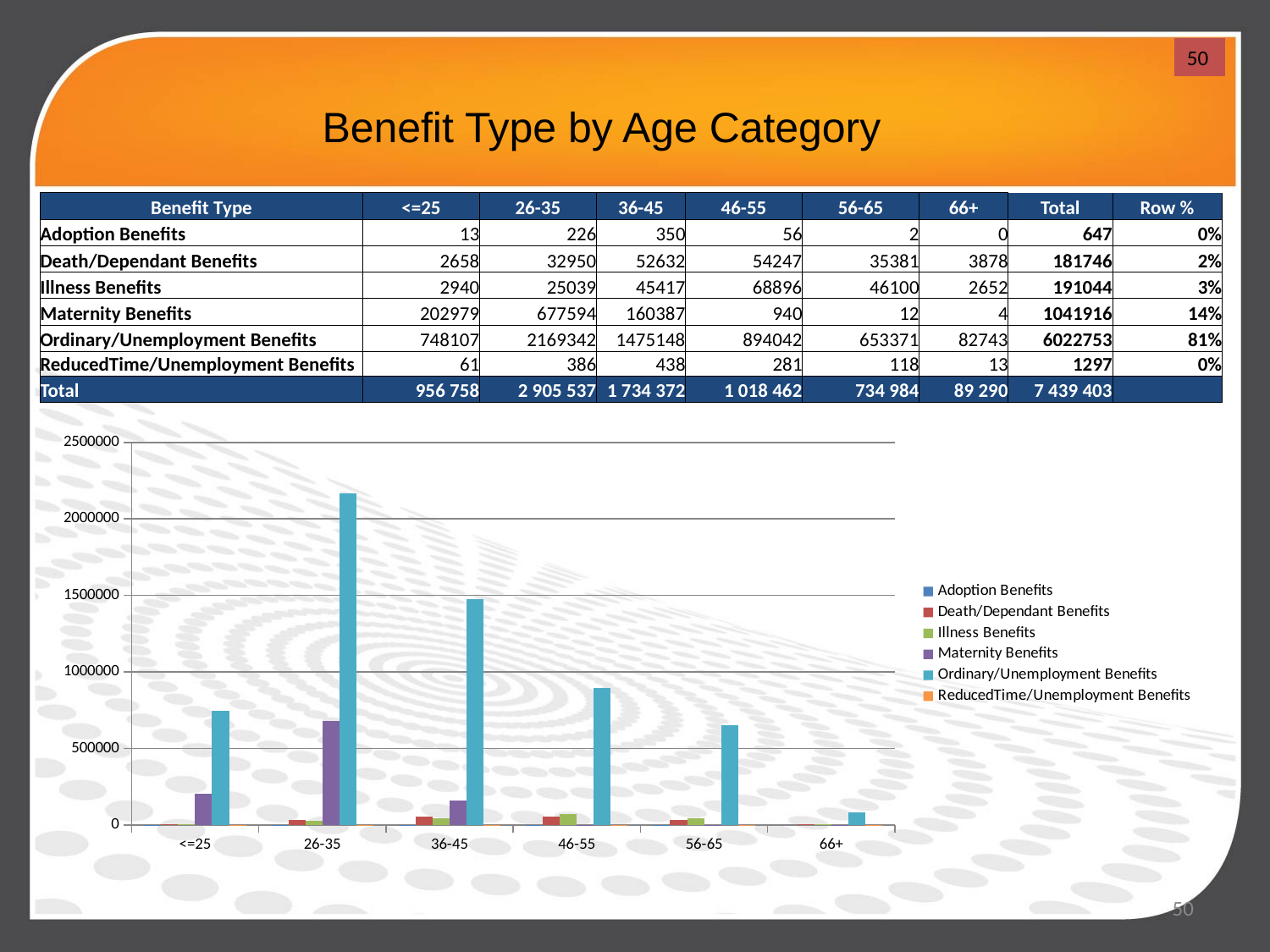
What kind of chart is shown on the slide? Bar chart Which is larger: Ordinary/Unemployment Benefits for <=25 or Maternity Benefits for 26-35? Ordinary/Unemployment Benefits for <=25 Which age category has the lowest bar for Ordinary/Unemployment Benefits? 66+ Is the Maternity Benefits bar for 26-35 greater or less than 500000? greater Is the Ordinary/Unemployment Benefits bar for 26-35 greater or less than 2000000? greater According to the table, what is the value of Maternity Benefits for the <=25 age category? 202979 How many age categories are shown on the x axis of the chart? 6 Which age category has the highest bar for Ordinary/Unemployment Benefits? 26-35 Is the Ordinary/Unemployment Benefits bar for 46-55 greater or less than 1000000? less According to the table, what is the value of Ordinary/Unemployment Benefits for the 26-35 age category? 2169342 Do the Ordinary/Unemployment Benefits bars rise or fall from 26-35 through 66+? Fall How many series does the chart legend list? 6